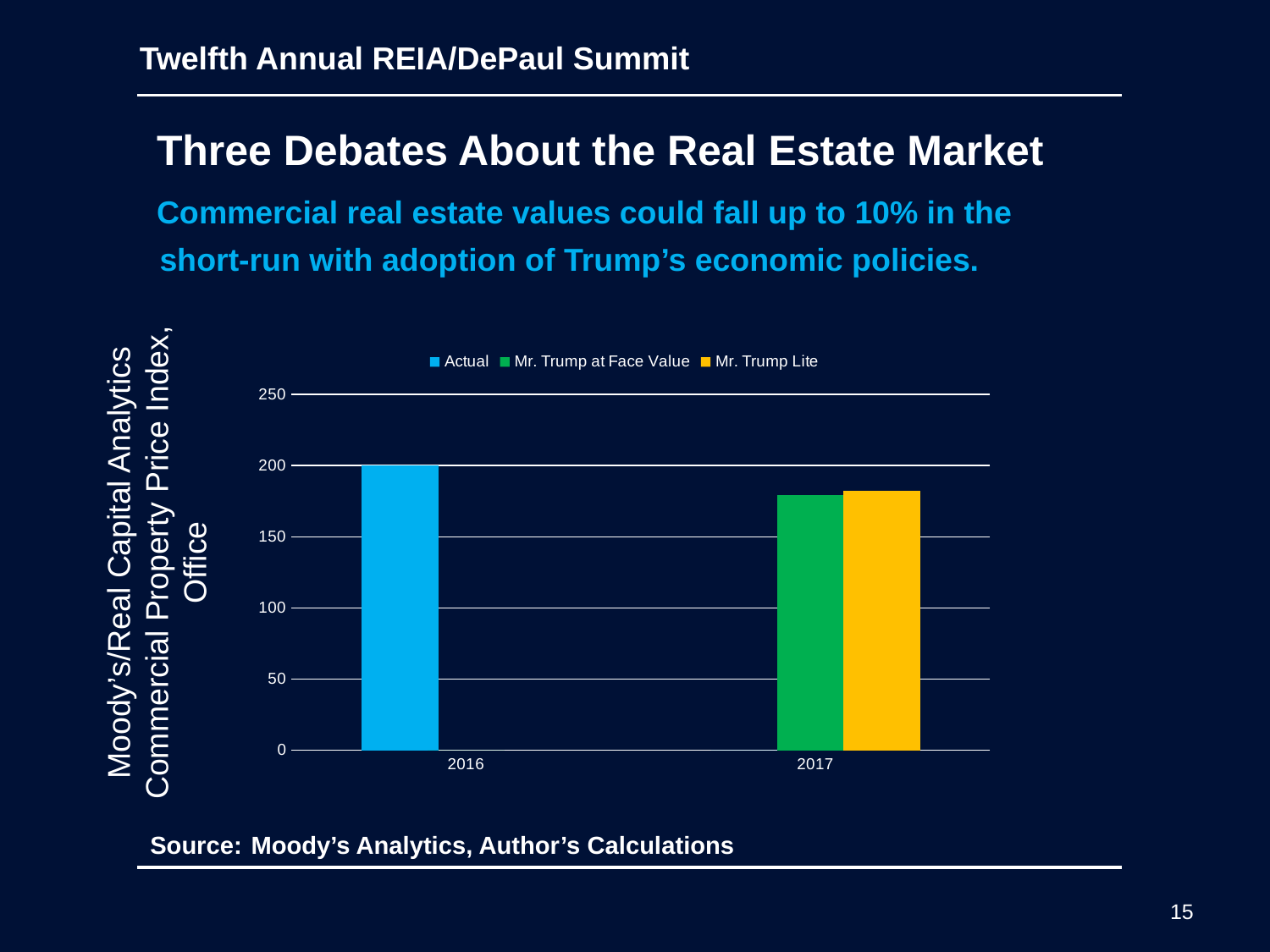
How many categories are shown on the x axis? 2 Which is larger: the Actual value for 2016 or the Mr. Trump at Face Value value for 2017? Actual for 2016 Is the value for Mr. Trump at Face Value in 2017 greater or less than 200? less What kind of chart is shown on the slide? bar chart How many series does the legend list? 3 Is the value for Mr. Trump at Face Value in 2017 greater or less than 150? greater Which series has the tallest bar on the chart? Actual What colour is the Actual series bar? blue Is the value for Mr. Trump Lite in 2017 greater or less than 150? greater What is the value of the Actual series for 2016? 200 What are the three series listed in the legend? Actual, Mr. Trump at Face Value, Mr. Trump Lite Do the bar values rise or fall from 2016 to 2017? fall